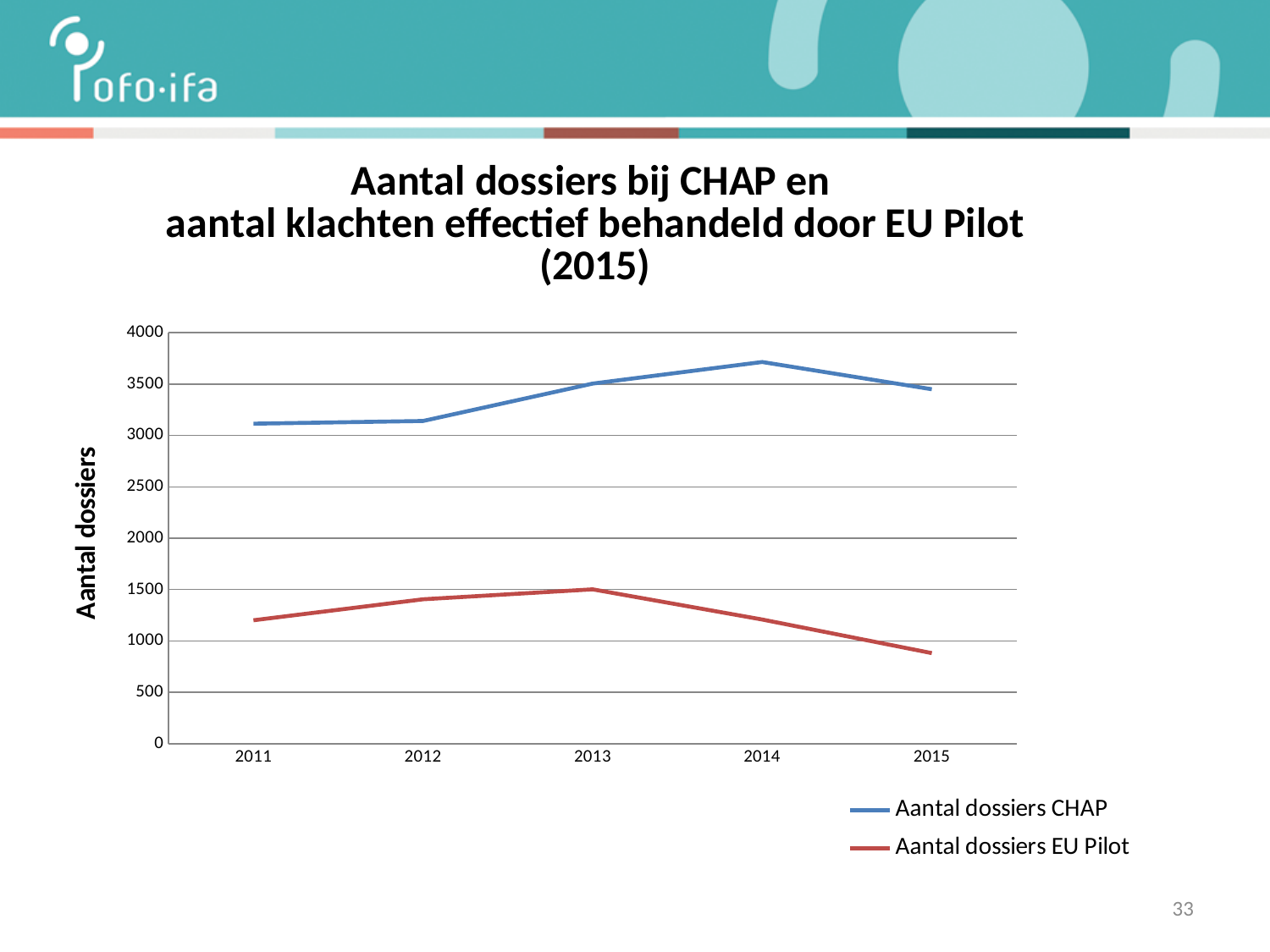
Is the value for Aantal dossiers EU Pilot in 2015 greater or less than 1000? less Which series has the larger value in 2013, Aantal dossiers CHAP or Aantal dossiers EU Pilot? Aantal dossiers CHAP What kind of chart is shown on the slide? line chart In which year is the value for Aantal dossiers CHAP highest? 2014 What is the label of the y axis? Aantal dossiers Is the value for Aantal dossiers CHAP in 2011 greater or less than 3000? greater Is the value for Aantal dossiers CHAP in 2014 greater or less than 3500? greater How many series does the legend list? 2 How many years are plotted along the x axis? 5 In which year is the value for Aantal dossiers EU Pilot highest? 2013 In which year is the value for Aantal dossiers EU Pilot lowest? 2015 Does the value for Aantal dossiers EU Pilot rise or fall from 2013 to 2015? fall